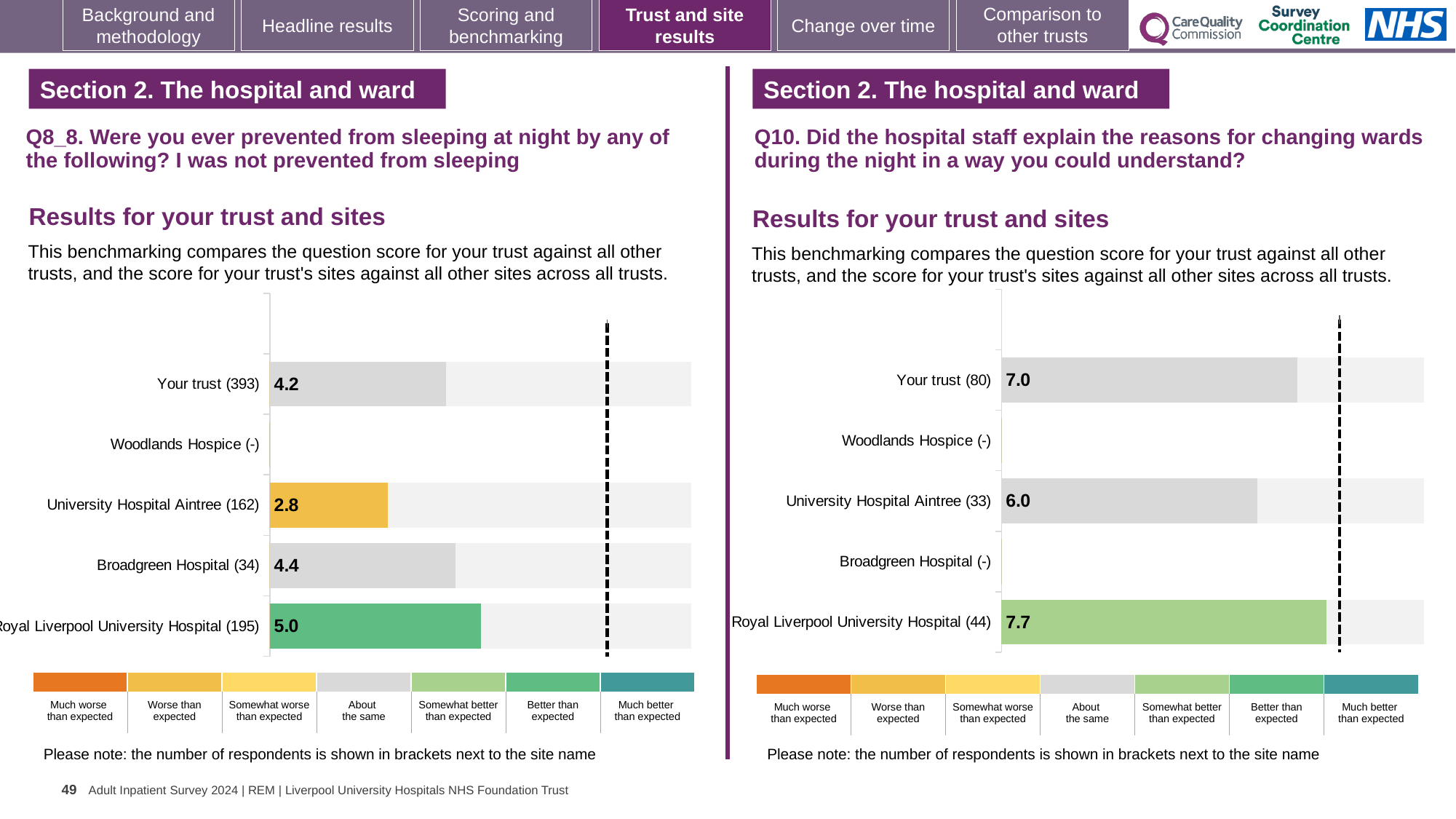
What type of chart is used on the left (Q8_8)? Bar chart In the left chart (Q8_8), which site with a plotted score has the lowest score? University Hospital Aintree How many site rows (including Your trust) are listed on the right chart (Q10)? 5 In the left chart (Q8_8), how many respondents are shown for Your trust? 393 In the left chart (Q8_8), which site has the highest score? Royal Liverpool University Hospital In the left chart (Q8_8), what is the score for Your trust? 4.2 In the right chart (Q10), what is the score for Royal Liverpool University Hospital? 7.7 In the right chart (Q10), which is larger, the score for Your trust or the score for University Hospital Aintree? Your trust In the right chart (Q10), what is the score for University Hospital Aintree? 6.0 In the left chart (Q8_8), what is the score for University Hospital Aintree? 2.8 In the left chart (Q8_8), what is the difference between the scores for Royal Liverpool University Hospital and Broadgreen Hospital? 0.6 In the right chart (Q10), what is the difference between the scores for Royal Liverpool University Hospital and Your trust? 0.7